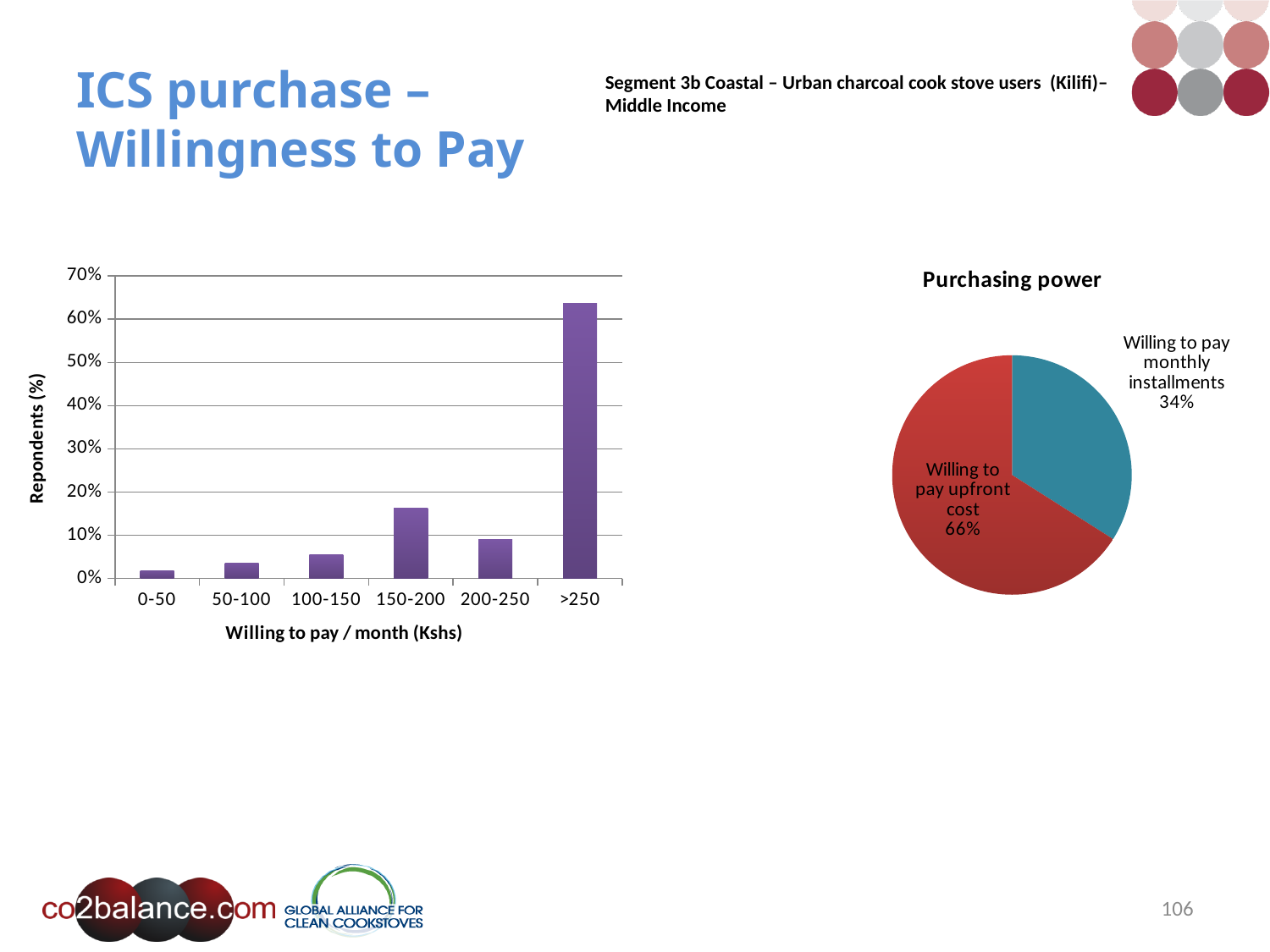
In the bar chart on the left, which is larger: the value for 150-200 or the value for 200-250? 150-200 In the bar chart on the left, is the value for >250 greater or less than 60%? greater In the Purchasing power chart, what share of respondents are willing to pay the upfront cost? 66% In the bar chart on the left, which willing-to-pay category has the highest share of respondents? >250 In the Purchasing power chart, what is the difference between the share willing to pay upfront cost and the share willing to pay monthly installments? 32% In the bar chart on the left, which willing-to-pay category has the lowest share of respondents? 0-50 In the bar chart on the left, is the value for 150-200 greater or less than 20%? less In the Purchasing power chart, what share of respondents are willing to pay monthly installments? 34% What type of chart is the chart on the left of the slide? bar chart In the bar chart on the left, what is the label of the x axis? Willing to pay / month (Kshs) How many willing-to-pay categories are shown on the x axis of the bar chart on the left? 6